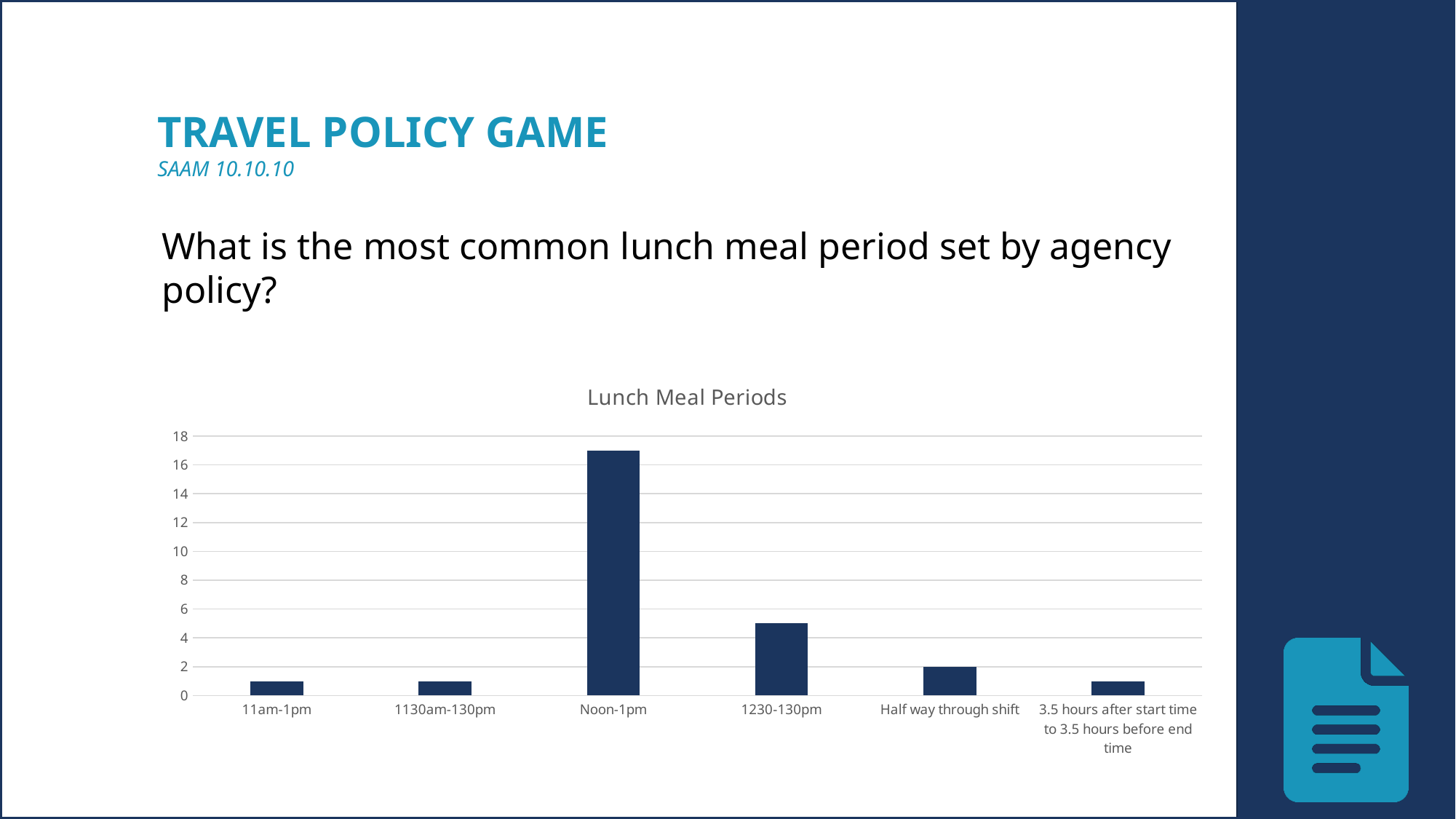
Is the value for Noon-1pm greater or less than 16? greater Which is larger, the value for Noon-1pm or the value for 1230-130pm? Noon-1pm Is the value for 1230-130pm greater or less than 6? less Is the value for 1230-130pm greater or less than 4? greater What type of chart is shown on the slide? bar chart How many lunch meal period categories are shown on the x axis? 6 Which lunch meal period has the highest bar? Noon-1pm What is the value for Half way through shift? 2 What is the title of the chart? Lunch Meal Periods Which is larger, the value for Half way through shift or the value for 1230-130pm? 1230-130pm